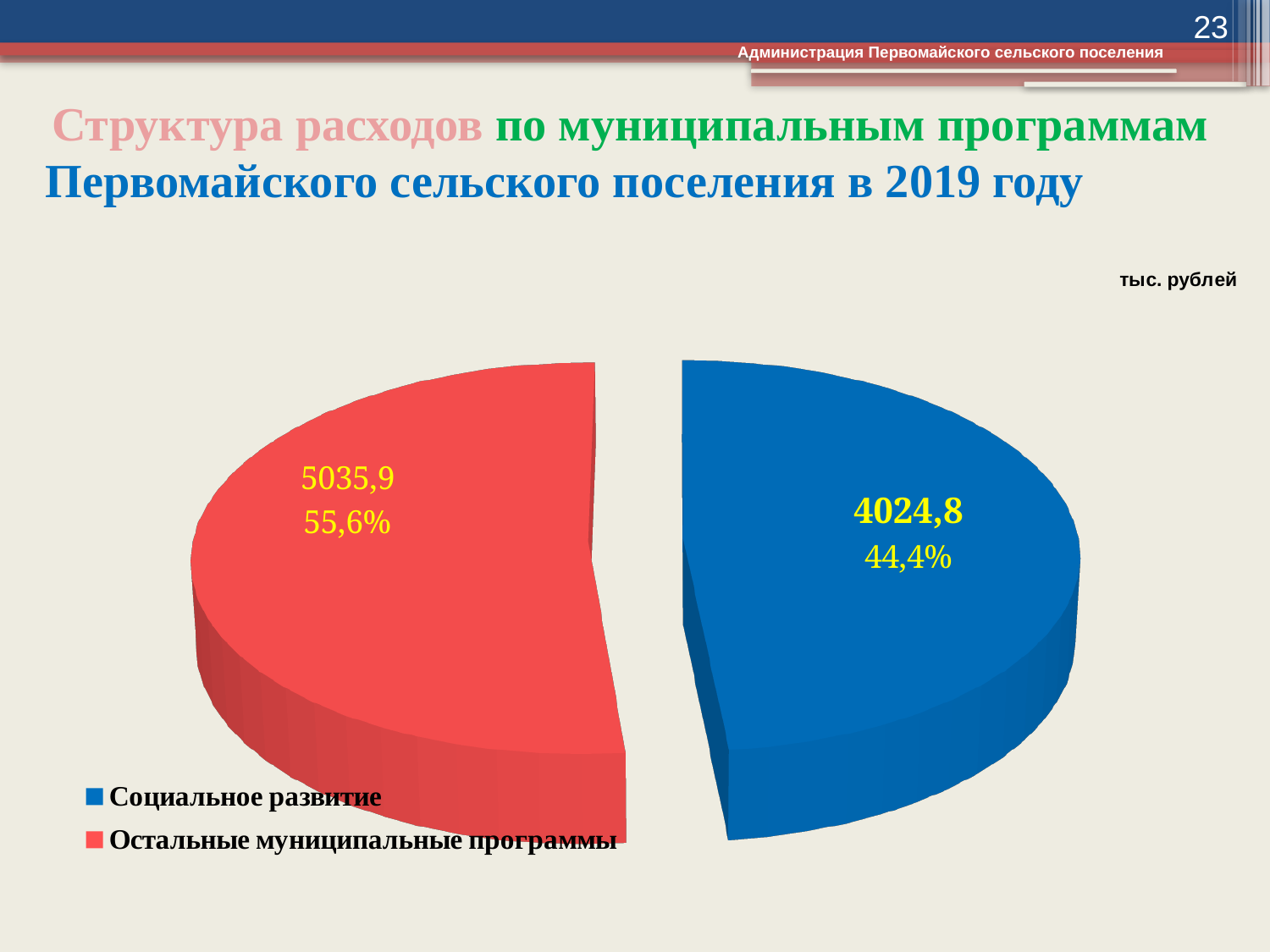
What is the value for Социальное развитие? 4024,8 What is the difference between the values for Остальные муниципальные программы and Социальное развитие? 1011,1 What unit is indicated for the chart values? тыс. рублей What colour is the slice for Социальное развитие? blue Which category has the largest slice? Остальные муниципальные программы How many slices does the pie chart have? 2 Which is larger: Социальное развитие or Остальные муниципальные программы? Остальные муниципальные программы What share of the pie does Остальные муниципальные программы take? 55,6% What share of the pie does Социальное развитие take? 44,4% What kind of chart is shown on the slide? pie chart Which category has the smallest slice? Социальное развитие What is the value for Остальные муниципальные программы? 5035,9